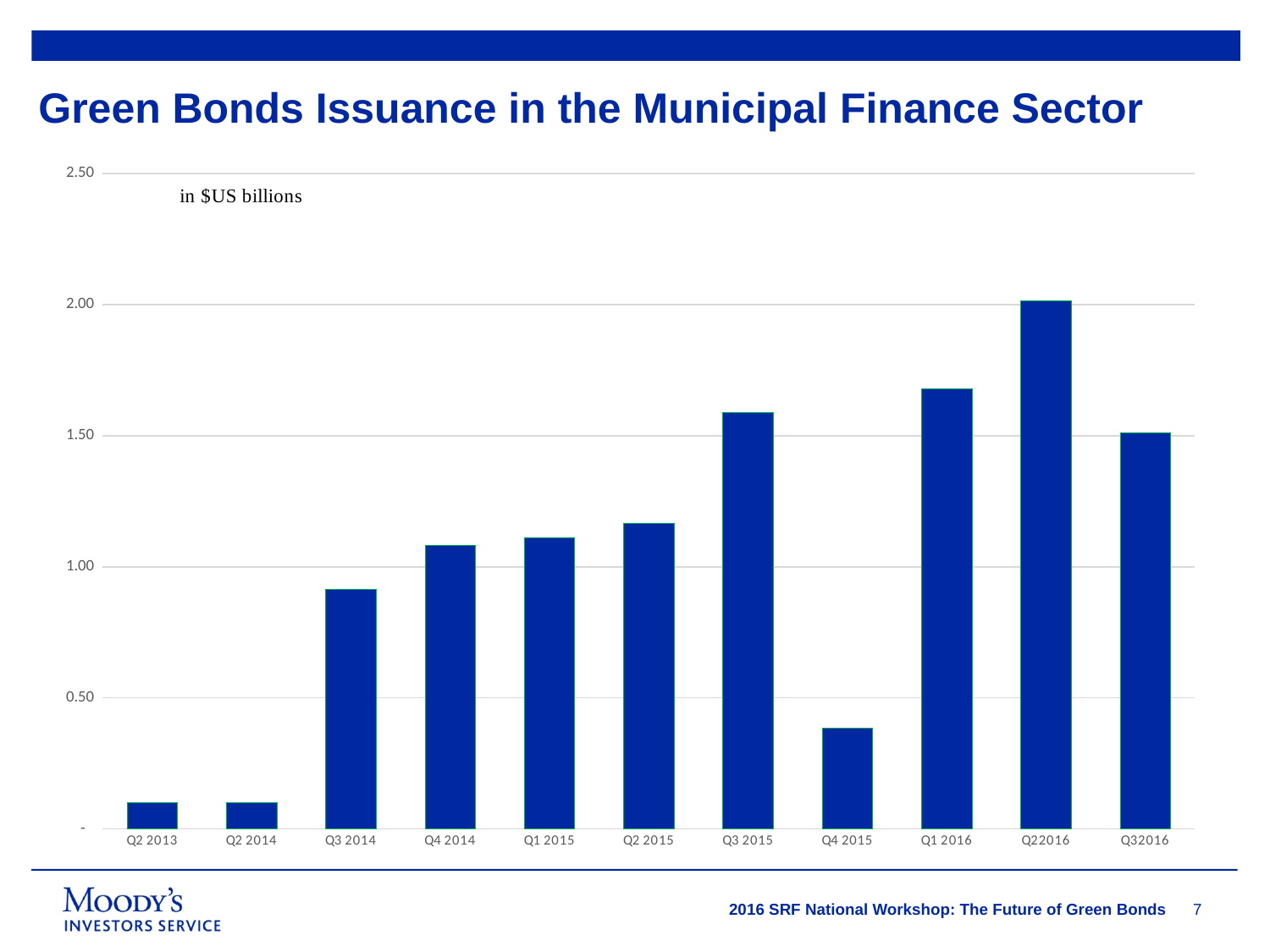
Which is larger, the value for Q4 2015 or the value for Q3 2014? Q3 2014 How many quarters are plotted on the x axis of the chart? 11 Is the value for Q1 2016 greater or less than 1.50? greater Is the value for Q3 2015 greater or less than 1.50? greater Which quarter has the highest green bonds issuance in the chart? Q22016 Is the value for Q2 2015 greater or less than 1.00? greater What unit are the values in the chart expressed in, according to the label on the chart? in $US billions Which is larger, the value for Q3 2015 or the value for Q2 2015? Q3 2015 What kind of chart is shown on the slide? Bar chart What is the title of the chart on the slide? Green Bonds Issuance in the Municipal Finance Sector